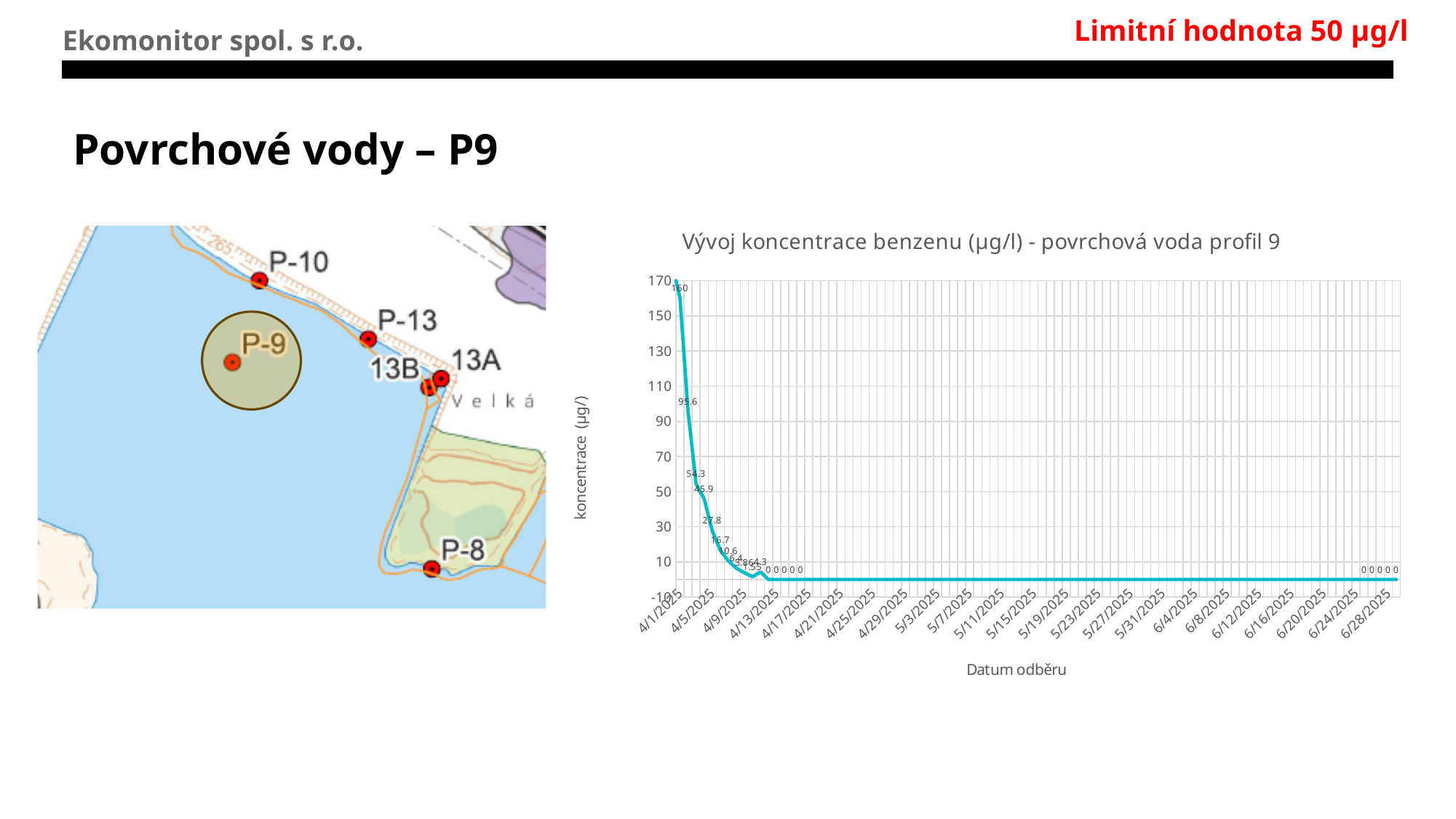
What is the title of the chart? Vývoj koncentrace benzenu (µg/l) - povrchová voda profil 9 What is the value of the last data point, at 6/28/2025? 0 Do the values rise or fall along the x axis from 4/1/2025 onward? fall What is the highest data label shown on the chart? 160 Is the value at 4/1/2025 greater or less than 150? greater Is the value at 5/3/2025 greater or less than 10? less What is the label of the vertical axis of the chart? koncentrace (µg/l) What is the value of the first data point, at 4/1/2025? 160 Which is larger: the first labelled value (160) or the third labelled value (54.3)? 160 What is the second data label shown on the chart, immediately after 160? 95.6 What kind of chart is shown on the slide? line chart What is the difference between the first two labelled values, 160 and 95.6? 64.4